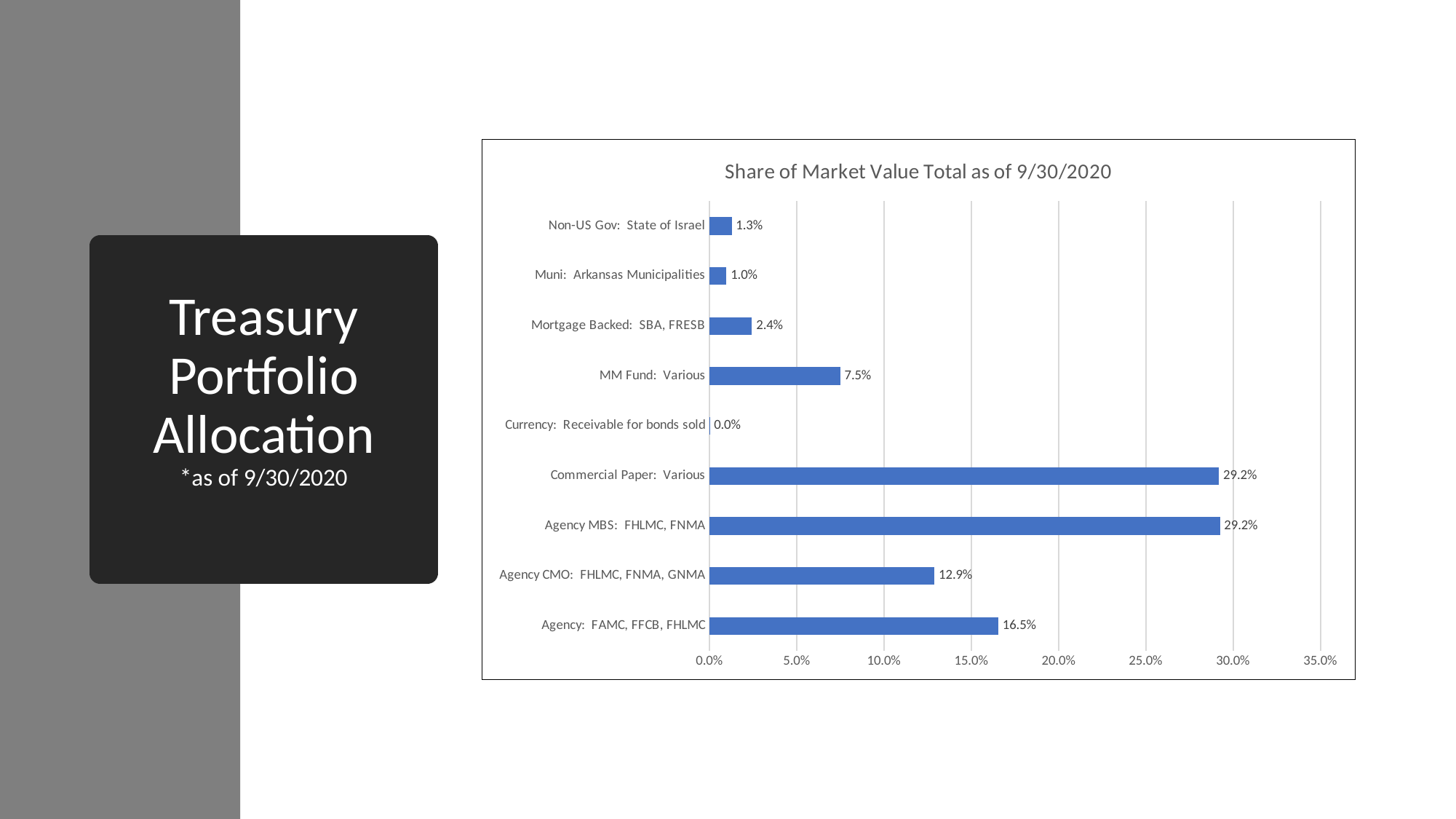
What is the value for Commercial Paper: Various? 29.2% How many categories are shown in the chart? 9 What is the difference between the values for Non-US Gov: State of Israel and Muni: Arkansas Municipalities? 0.3% Which category has the lowest value? Currency: Receivable for bonds sold What is the title of the chart? Share of Market Value Total as of 9/30/2020 What is the difference between the values for Agency: FAMC, FFCB, FHLMC and Agency CMO: FHLMC, FNMA, GNMA? 3.6% What is the value for MM Fund: Various? 7.5% What is the value for Mortgage Backed: SBA, FRESB? 2.4% Is the value for Agency MBS: FHLMC, FNMA greater or less than 25.0%? greater Which is larger, the value for Agency: FAMC, FFCB, FHLMC or the value for MM Fund: Various? Agency: FAMC, FFCB, FHLMC What is the value for Agency CMO: FHLMC, FNMA, GNMA? 12.9% What kind of chart is shown on the slide? bar chart